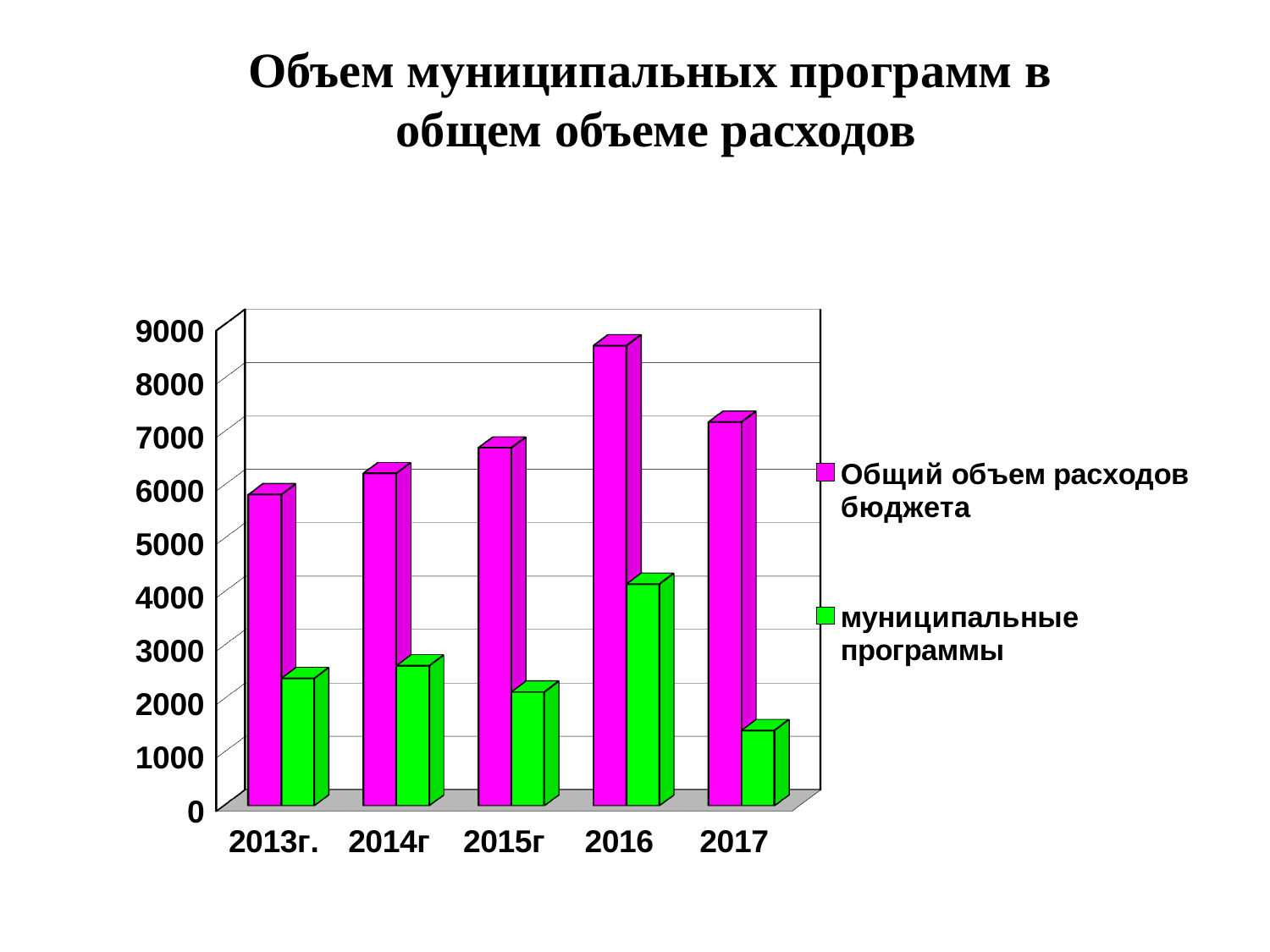
In which year is the value for муниципальные программы lowest? 2017 What colour are the bars for муниципальные программы? green Is the value for муниципальные программы in 2016 greater or less than 3000? greater Which is larger: Общий объем расходов бюджета in 2015г or in 2017? 2017 In which year is the value for муниципальные программы highest? 2016 In which year is the value for Общий объем расходов бюджета highest? 2016 In which year is the value for Общий объем расходов бюджета lowest? 2013г. Is the value for Общий объем расходов бюджета in 2016 greater or less than 8000? greater How many years are shown on the x axis? 5 What kind of chart is shown on the slide? bar chart Is the value for муниципальные программы in 2017 greater or less than 2000? less How many series does the legend list? 2